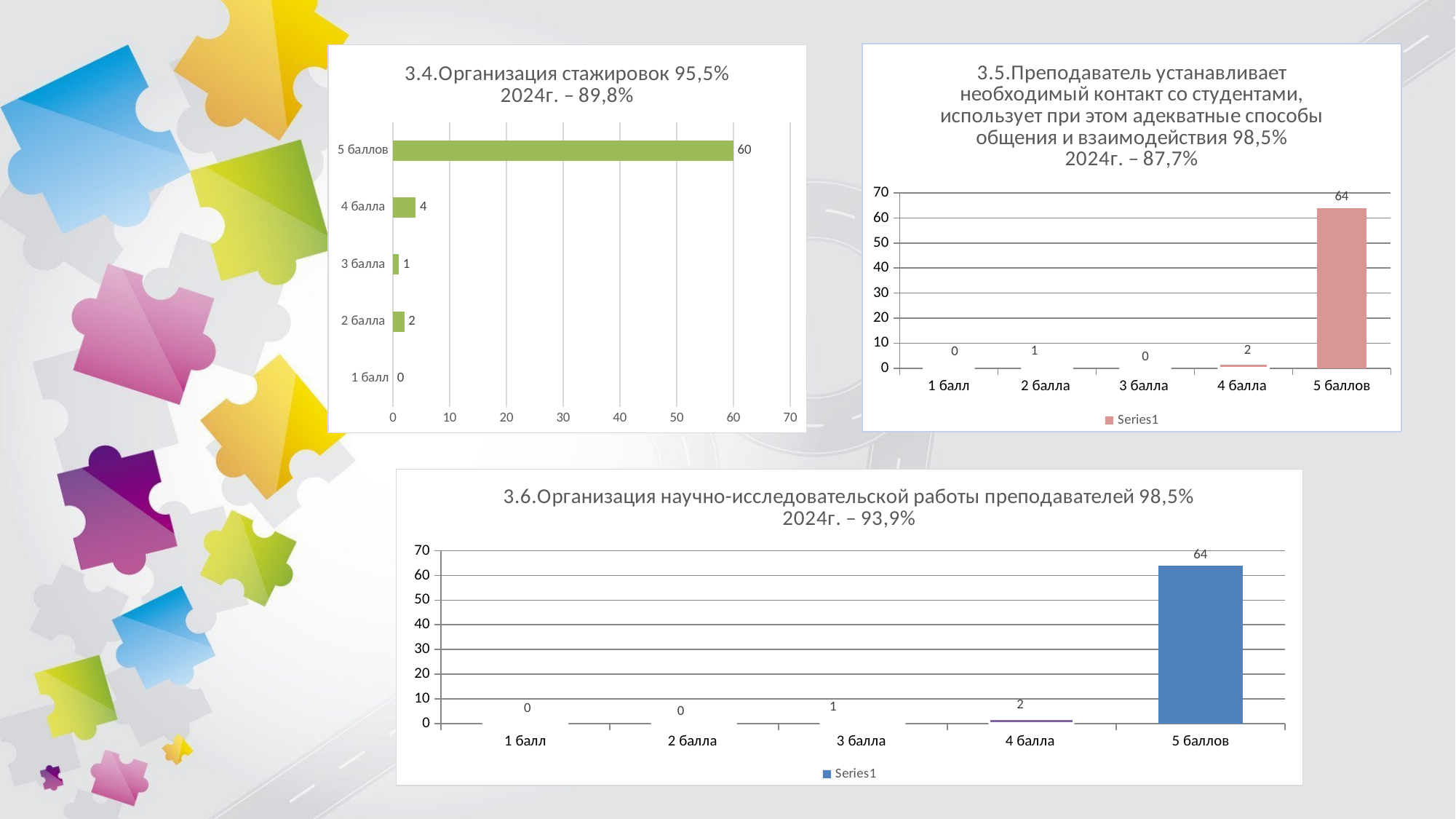
In the bottom chart (3.6), what is the value for "3 балла"? 1 In the chart titled "3.4.Организация стажировок", which category has the lowest value? 1 балл In the top-right chart (3.5), which category has the highest value? 5 баллов What kind of chart is the chart titled "3.4.Организация стажировок"? Bar chart In the chart titled "3.4.Организация стажировок", what is the value for "4 балла"? 4 How many series does the legend of the bottom chart (3.6) list? 1 In the chart titled "3.4.Организация стажировок", what is the value for "5 баллов"? 60 In the top-right chart (3.5), what is the value for "5 баллов"? 64 In the chart titled "3.4.Организация стажировок", what is the difference between the values for "5 баллов" and "4 балла"? 56 In the top-right chart (3.5), what is the value for "4 балла"? 2 How many categories are shown on the x axis of the top-right chart (3.5)? 5 In the bottom chart (3.6), is the value for "5 баллов" greater or less than 60? greater